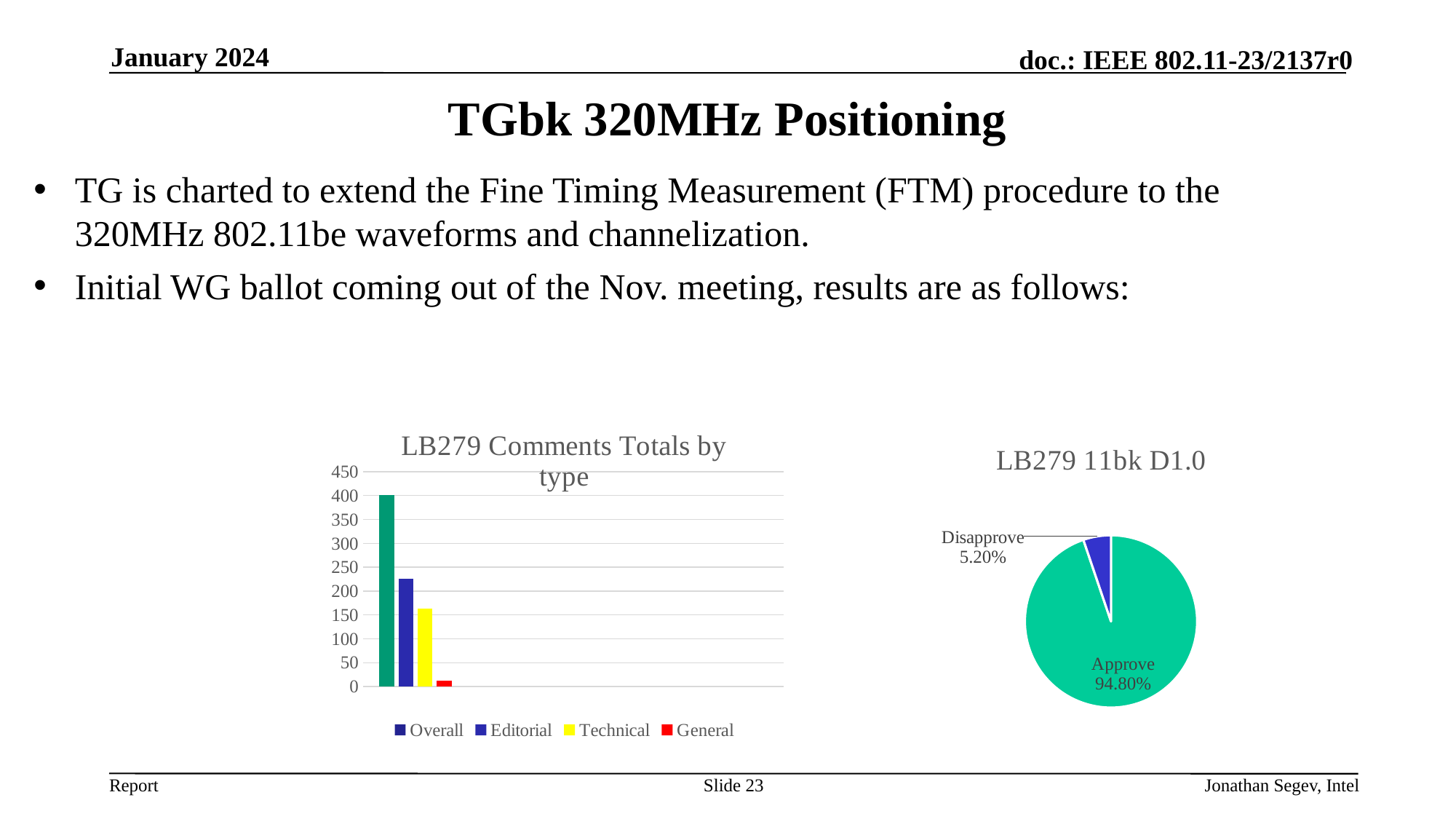
In the 'LB279 Comments Totals by type' chart, is the value for General greater or less than 50? less In the 'LB279 11bk D1.0' pie chart, what share is labelled for Disapprove? 5.20% In the 'LB279 11bk D1.0' pie chart, what share is labelled for Approve? 94.80% In the 'LB279 Comments Totals by type' chart, how many series does the legend list? 4 In the 'LB279 11bk D1.0' pie chart, how many slices are there? 2 In the 'LB279 Comments Totals by type' chart, is the value for Overall greater or less than 350? greater In the 'LB279 Comments Totals by type' chart, which is larger, Editorial or Technical? Editorial In the 'LB279 Comments Totals by type' chart, which series has the lowest value? General What kind of chart is the 'LB279 Comments Totals by type' chart? bar chart In the 'LB279 Comments Totals by type' chart, is the value for Editorial greater or less than 250? less In the 'LB279 Comments Totals by type' chart, which series has the highest value? Overall What kind of chart is the 'LB279 11bk D1.0' chart? pie chart